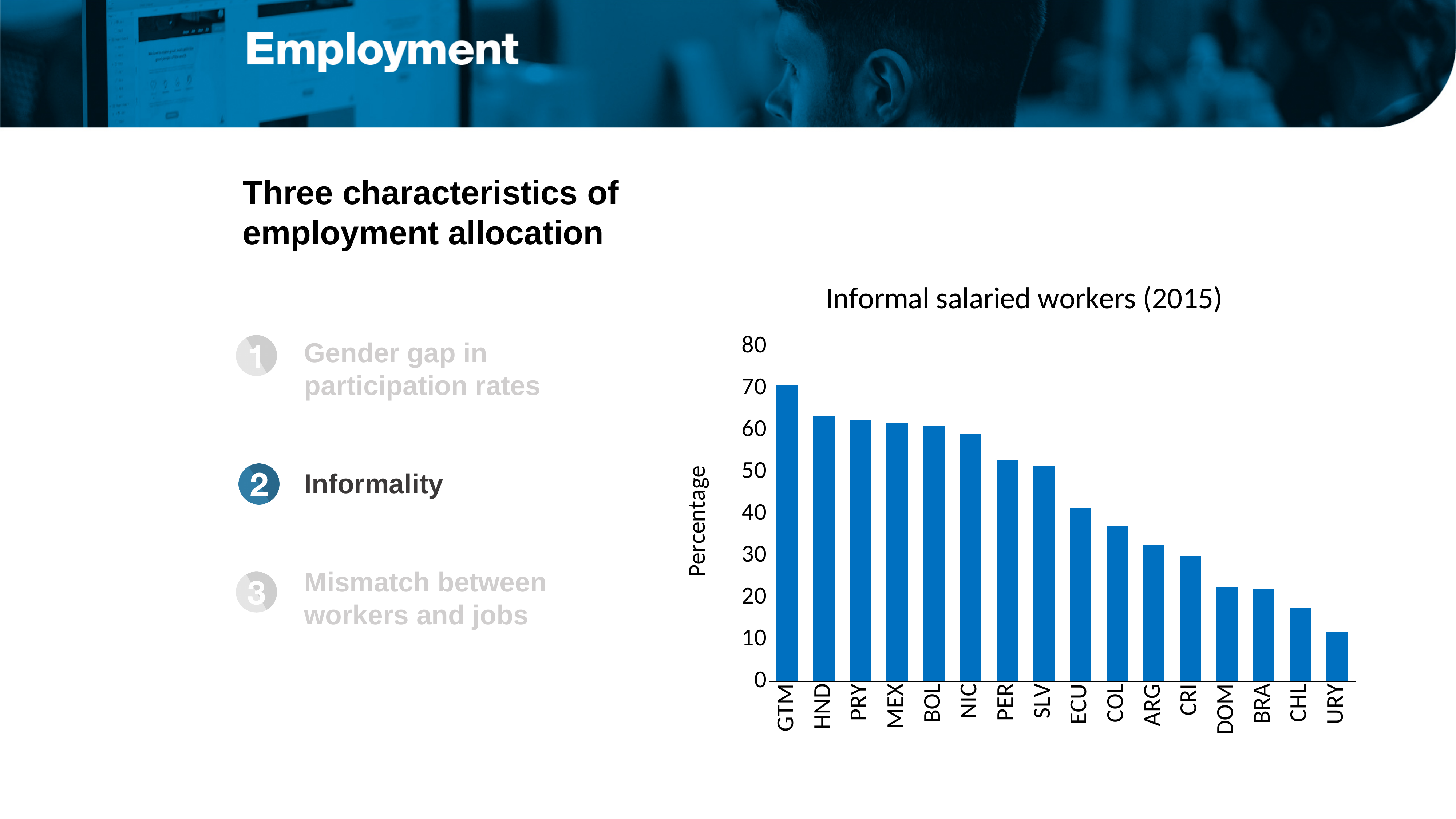
Do the values rise or fall moving from left to right along the x axis? fall What kind of chart is shown on the slide? bar chart What is the label on the vertical axis of the chart? Percentage Which country has the highest share of informal salaried workers? GTM Is the value for COL greater or less than 40? less Is the value for GTM greater or less than 60? greater What is the title of the chart? Informal salaried workers (2015) Which country has the lowest share of informal salaried workers? URY Which has a higher value, ECU or ARG? ECU Is the value for URY greater or less than 20? less How many countries are shown on the x axis of the chart? 16